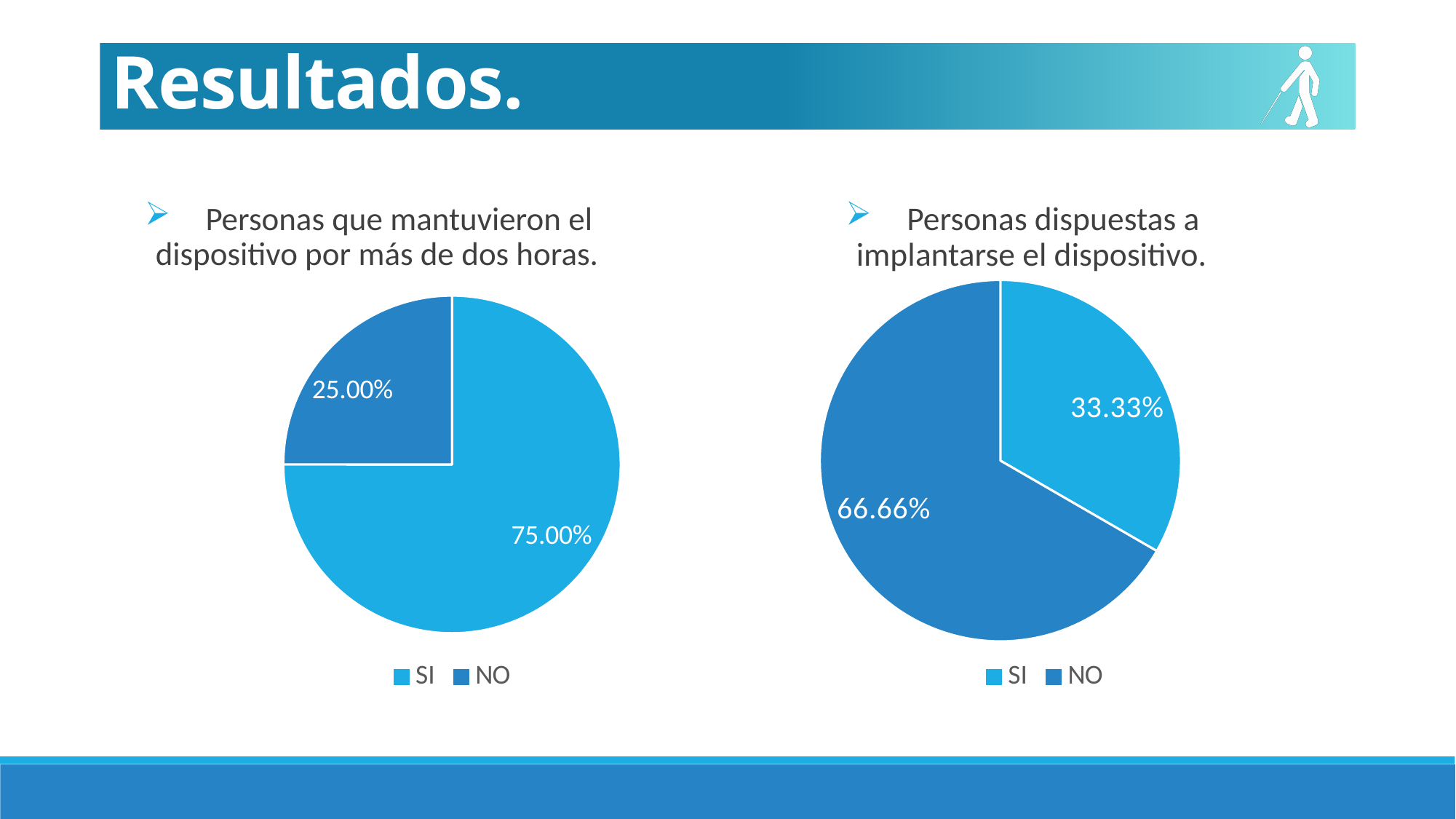
In the left pie chart, which category has the largest slice? SI In the right pie chart (Personas dispuestas a implantarse el dispositivo), what percentage is shown for NO? 66.66% In the left pie chart (Personas que mantuvieron el dispositivo por más de dos horas), what percentage is shown for NO? 25.00% In the right pie chart (Personas dispuestas a implantarse el dispositivo), what percentage is shown for SI? 33.33% How many pie charts are shown on the slide? 2 In the left pie chart, what is the difference in percentage points between SI and NO? 50.00% In the left pie chart (Personas que mantuvieron el dispositivo por más de dos horas), what percentage is shown for SI? 75.00% In the right pie chart, is the slice for NO larger or smaller than the slice for SI? larger What is the title of the right pie chart? Personas dispuestas a implantarse el dispositivo. What type of chart is used on the left side of the slide? Pie chart In the right pie chart, which category has the smallest slice? SI How many categories does the legend of the right pie chart list? 2